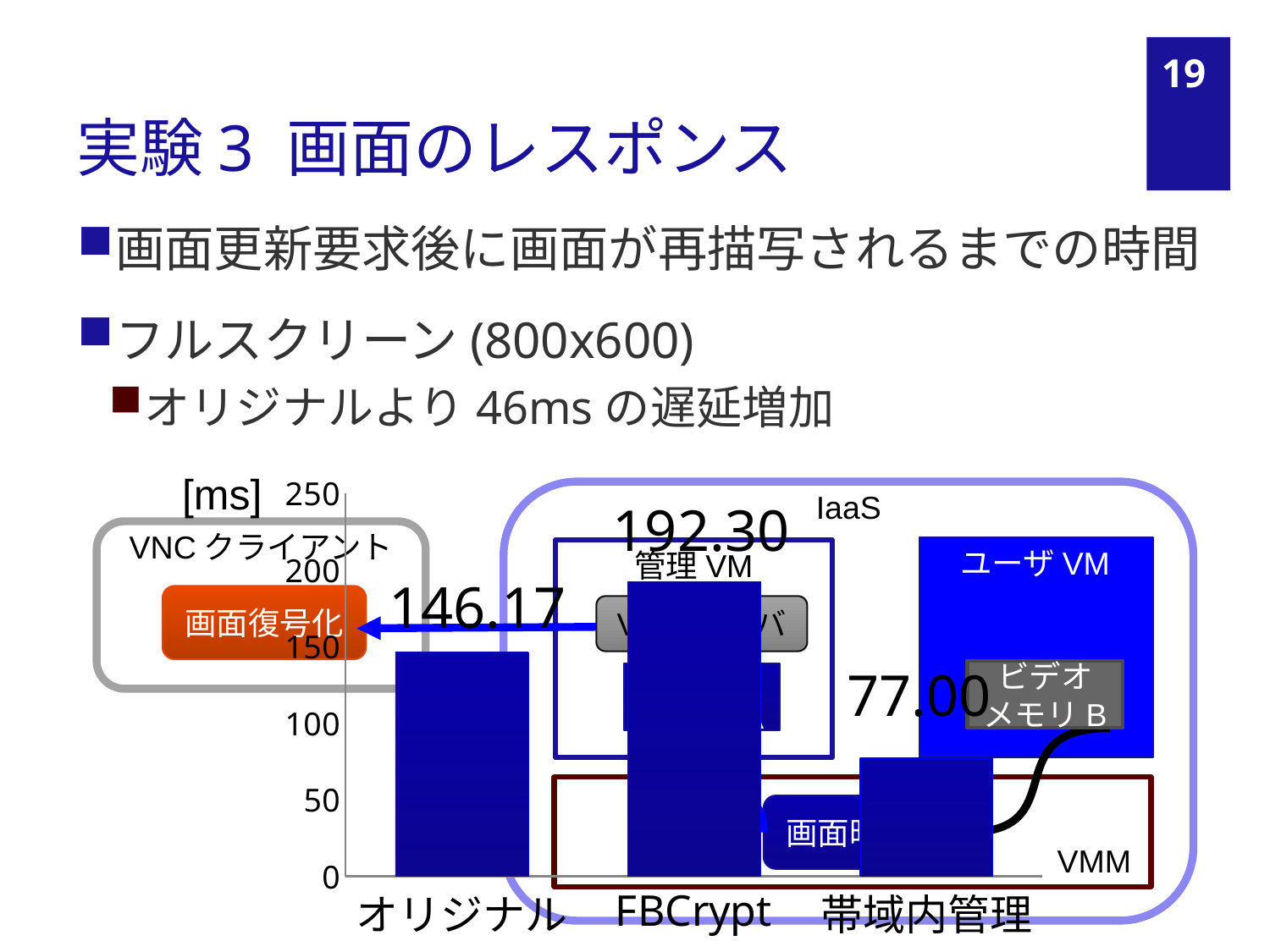
What is the difference between the values for FBCrypt and オリジナル? 46.13 Which category has the highest value in the bar chart? FBCrypt What unit is shown on the y axis of the chart? ms What kind of chart is shown on the slide? bar chart What is the value for FBCrypt in the bar chart? 192.30 Which is larger, the value for オリジナル or the value for 帯域内管理? オリジナル What is the value for オリジナル in the bar chart? 146.17 What is the value for 帯域内管理 in the bar chart? 77.00 What is the difference between the values for オリジナル and 帯域内管理? 69.17 Is the value for FBCrypt greater or less than 150? greater Which category has the lowest value in the bar chart? 帯域内管理 How many categories are shown in the bar chart? 3